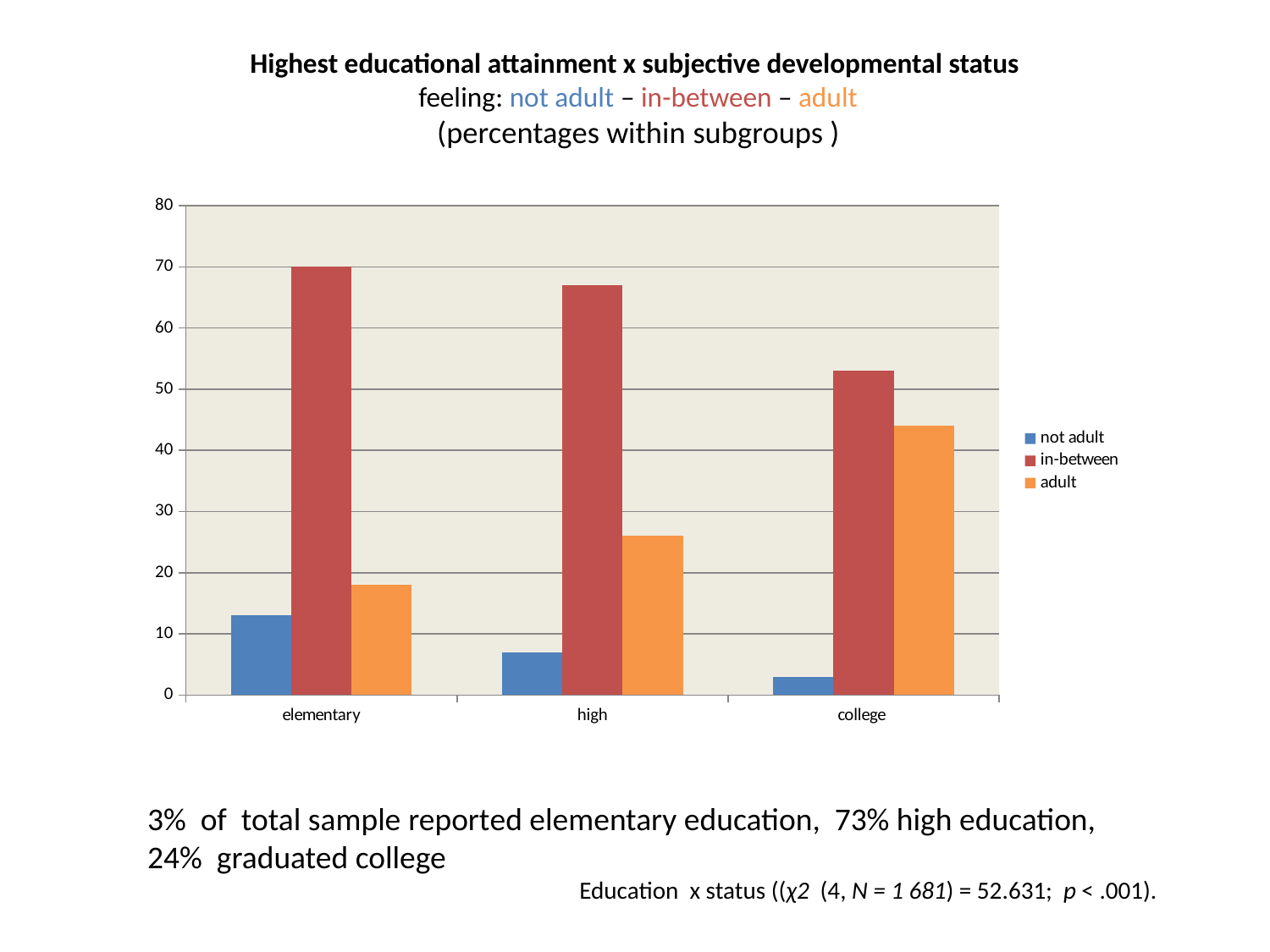
Which education group has the lowest not adult value? college Is the value for not adult in the high group greater or less than 10? less Is the value for adult in the college group greater or less than 40? greater How many series does the legend list? 3 Is the value for in-between in the college group greater or less than 50? greater Which is larger in the high group, the adult value or the not adult value? adult Which education group has the highest adult value? college What kind of chart is shown on the slide? bar chart How many education categories are shown on the x axis? 3 Do the not adult values rise or fall from elementary to college? fall What is the value for in-between in the elementary group? 70 Which education group has the highest in-between value? elementary